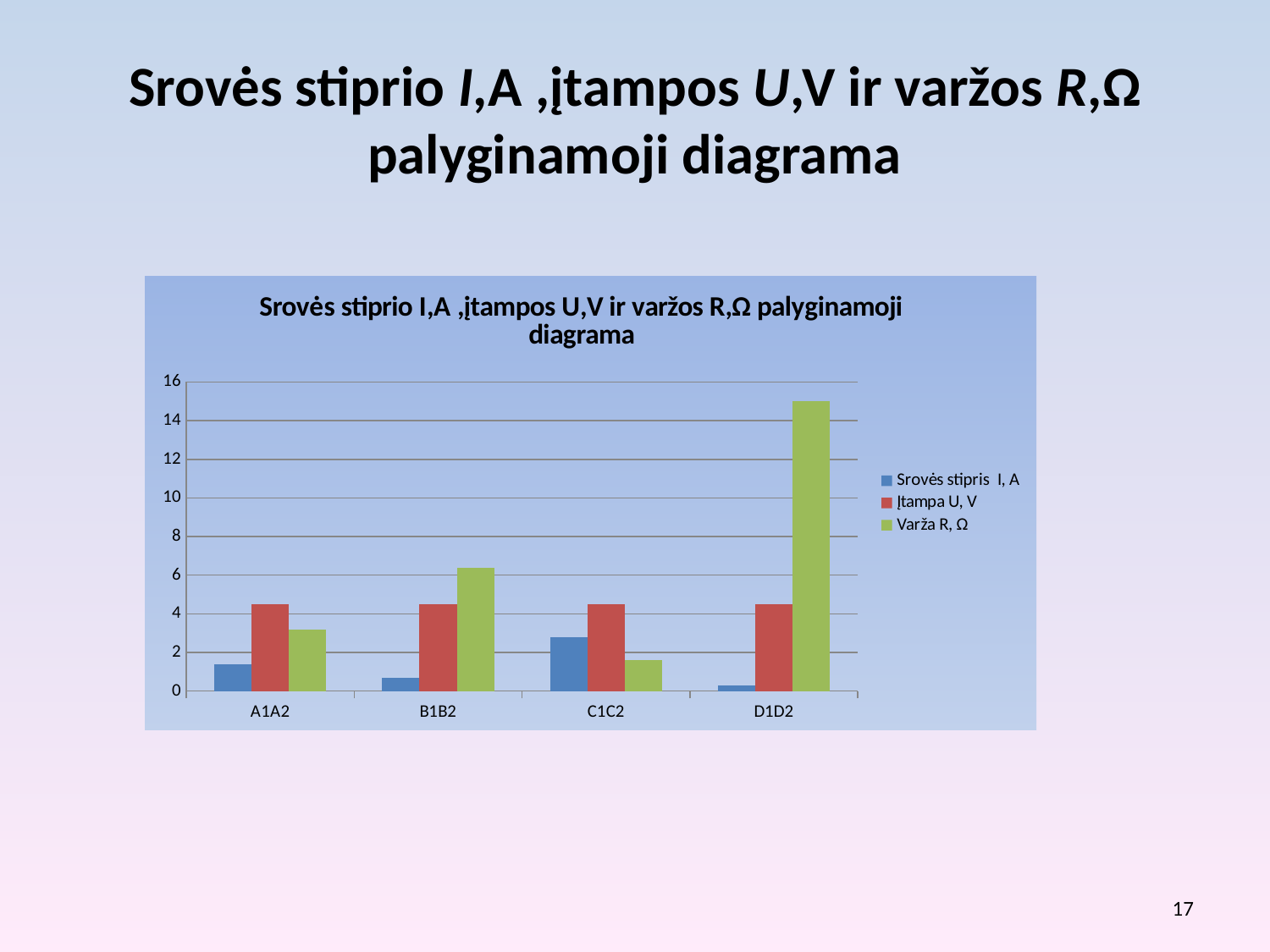
What kind of chart is shown on the slide? bar chart Which category has the highest value for Varža R, Ω? D1D2 Which category has the lowest value for Srovės stipris I, A? D1D2 Which category has the lowest value for Varža R, Ω? C1C2 How many series does the chart legend list? 3 Which category has the highest value for Srovės stipris I, A? C1C2 Which series is shown in green in the chart legend? Varža R, Ω How many categories are shown on the x axis of the chart? 4 Is the value for Varža R, Ω at B1B2 greater or less than 6? greater Which is larger at A1A2: Įtampa U, V or Varža R, Ω? Įtampa U, V Is the value for Srovės stipris I, A at A1A2 greater or less than 2? less Is the value for Varža R, Ω at D1D2 greater or less than 14? greater